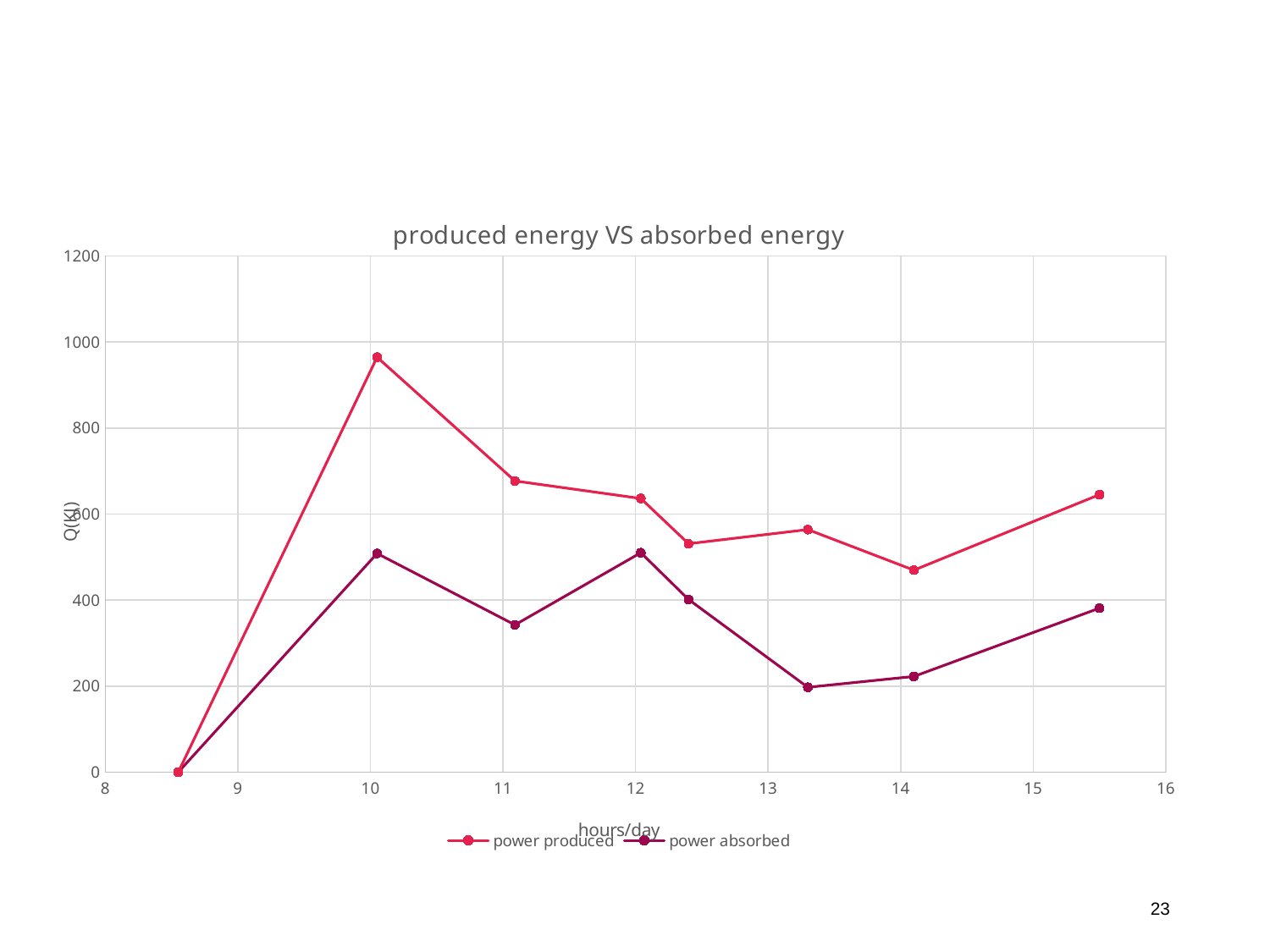
Does the power produced series rise or fall overall between 10 and 14 hours/day? fall Is the value of power absorbed at about 10 hours/day greater or less than 400? greater Is the value of power absorbed at about 11 hours/day greater or less than 400? less Is the value of power produced at about 14 hours/day greater or less than 600? less How many data points are plotted for the power produced series? 8 What are the two series named in the legend? power produced and power absorbed At about 12 hours/day, which series has the larger value, power produced or power absorbed? power produced What is the title of the chart? produced energy VS absorbed energy What kind of chart is shown on the slide? line chart How many series does the legend list? 2